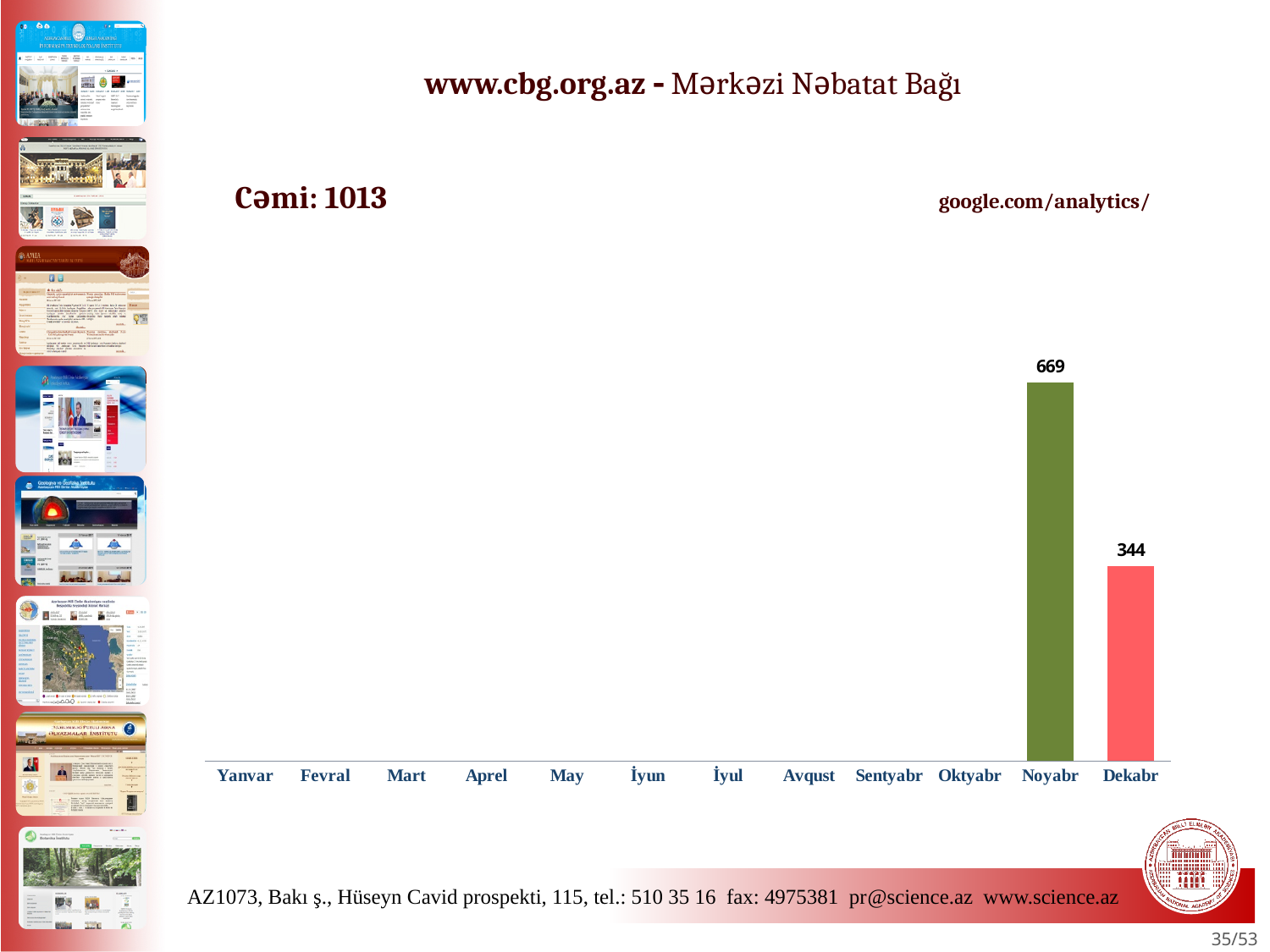
What is the difference between the values for Noyabr and Dekabr? 325 What total (Cəmi) is stated on the slide? 1013 What kind of chart is shown on the slide? bar chart What is the total of the values for Noyabr and Dekabr? 1013 Which month has the highest value? Noyabr What is the value for Noyabr? 669 How many months have a visible bar in the chart? 2 Do the values rise or fall from Noyabr to Dekabr? fall Which is larger, the value for Noyabr or the value for Dekabr? Noyabr How many month categories are shown on the x axis? 12 What is the value for Dekabr? 344 Which website is named in the slide title? www.cbg.org.az